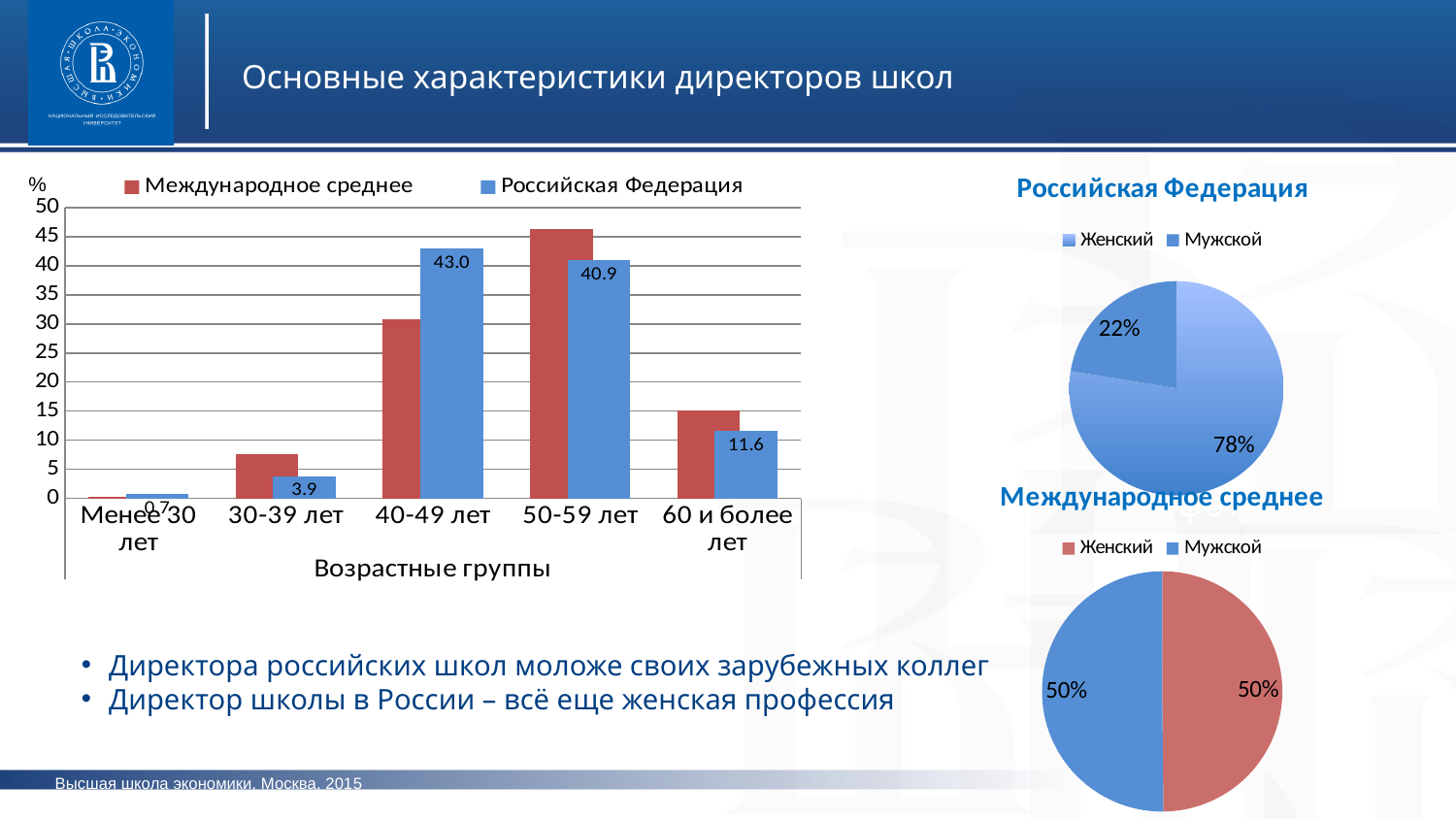
In the pie chart titled Международное среднее, what share is Мужской? 50% In the bar chart on the left, what is the difference between the Российская Федерация values for 40-49 лет and 50-59 лет? 2.1 How many age groups are shown on the x axis of the bar chart on the left? 5 In the bar chart on the left, which age group has the lowest value for the Российская Федерация series? Менее 30 лет In the bar chart on the left, what is the value for the Российская Федерация series in the 40-49 лет age group? 43.0 In the bar chart on the left, what is the value for the Российская Федерация series in the 30-39 лет age group? 3.9 In the bar chart on the left, which age group has the highest value for the Российская Федерация series? 40-49 лет How many series does the legend of the bar chart on the left list? 2 In the pie chart titled Российская Федерация, what share is Женский? 78% In the bar chart on the left, which series has the larger value in the 50-59 лет age group, Международное среднее or Российская Федерация? Международное среднее In the bar chart on the left, what is the value for the Российская Федерация series in the 60 и более лет age group? 11.6 In the bar chart on the left, is the Международное среднее value for 50-59 лет greater or less than 40? greater